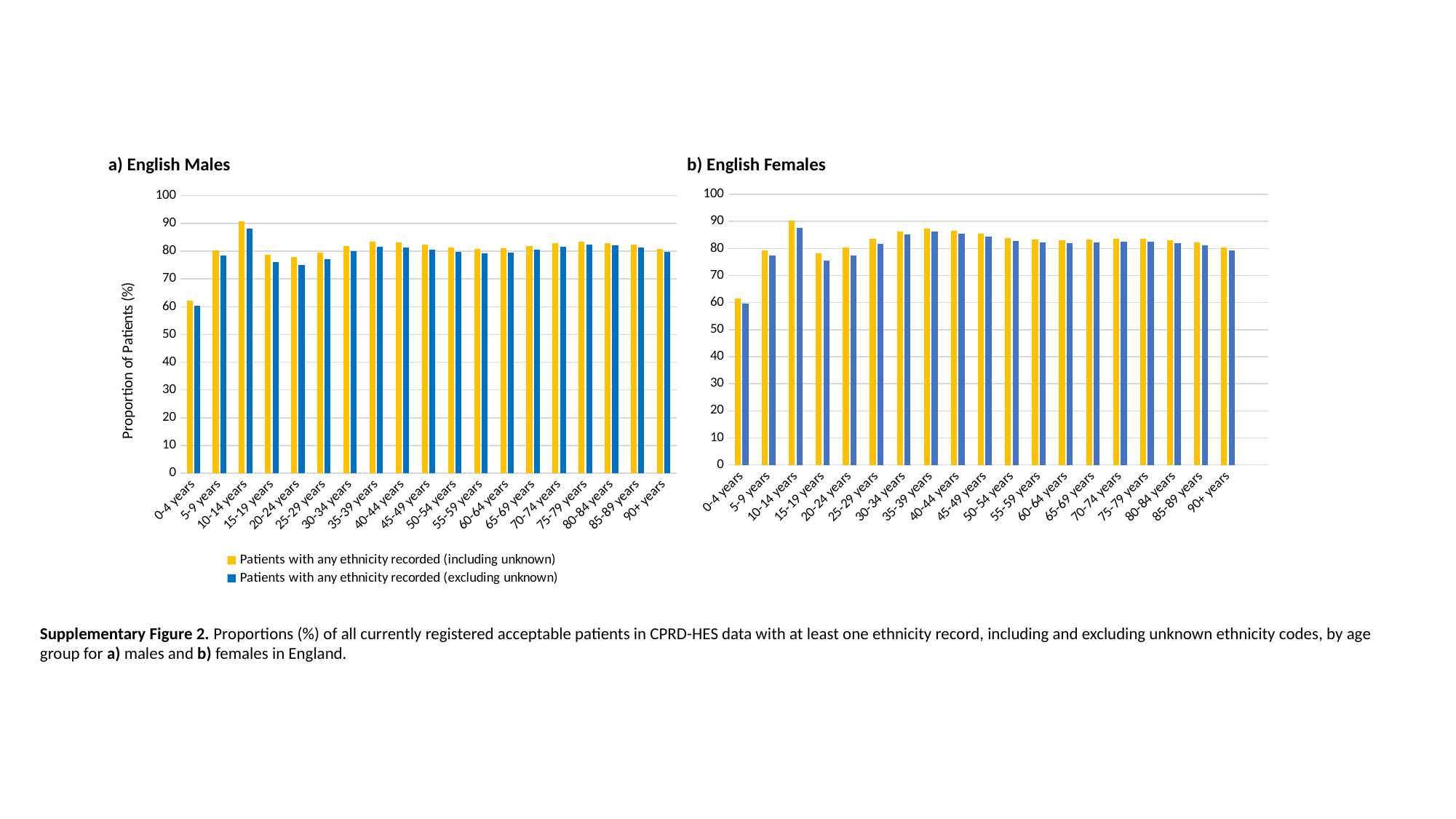
In the 'a) English Males' chart, is the value for 10-14 years (including unknown) greater or less than 80? greater In the 'b) English Females' chart, which is larger for patients with any ethnicity recorded (including unknown): 0-4 years or 5-9 years? 5-9 years What is the label on the y axis of the 'a) English Males' chart? Proportion of Patients (%) In the 'a) English Males' chart, is the value for 0-4 years (including unknown) greater or less than 70? less In the 'b) English Females' chart, which age group has the lowest proportion of patients with any ethnicity recorded (excluding unknown)? 0-4 years How many series does the legend list for the charts? 2 In the 'a) English Males' chart, which age group has the highest proportion of patients with any ethnicity recorded (including unknown)? 10-14 years In the 'b) English Females' chart, which age group has the highest proportion of patients with any ethnicity recorded (including unknown)? 10-14 years What kind of chart is used in the 'a) English Males' panel? Bar chart In the 'a) English Males' chart, which age group has the lowest proportion of patients with any ethnicity recorded (including unknown)? 0-4 years How many age-group categories are shown on the x axis of the 'b) English Females' chart? 19 In the 'b) English Females' chart, is the value for 20-24 years (excluding unknown) greater or less than 80? less